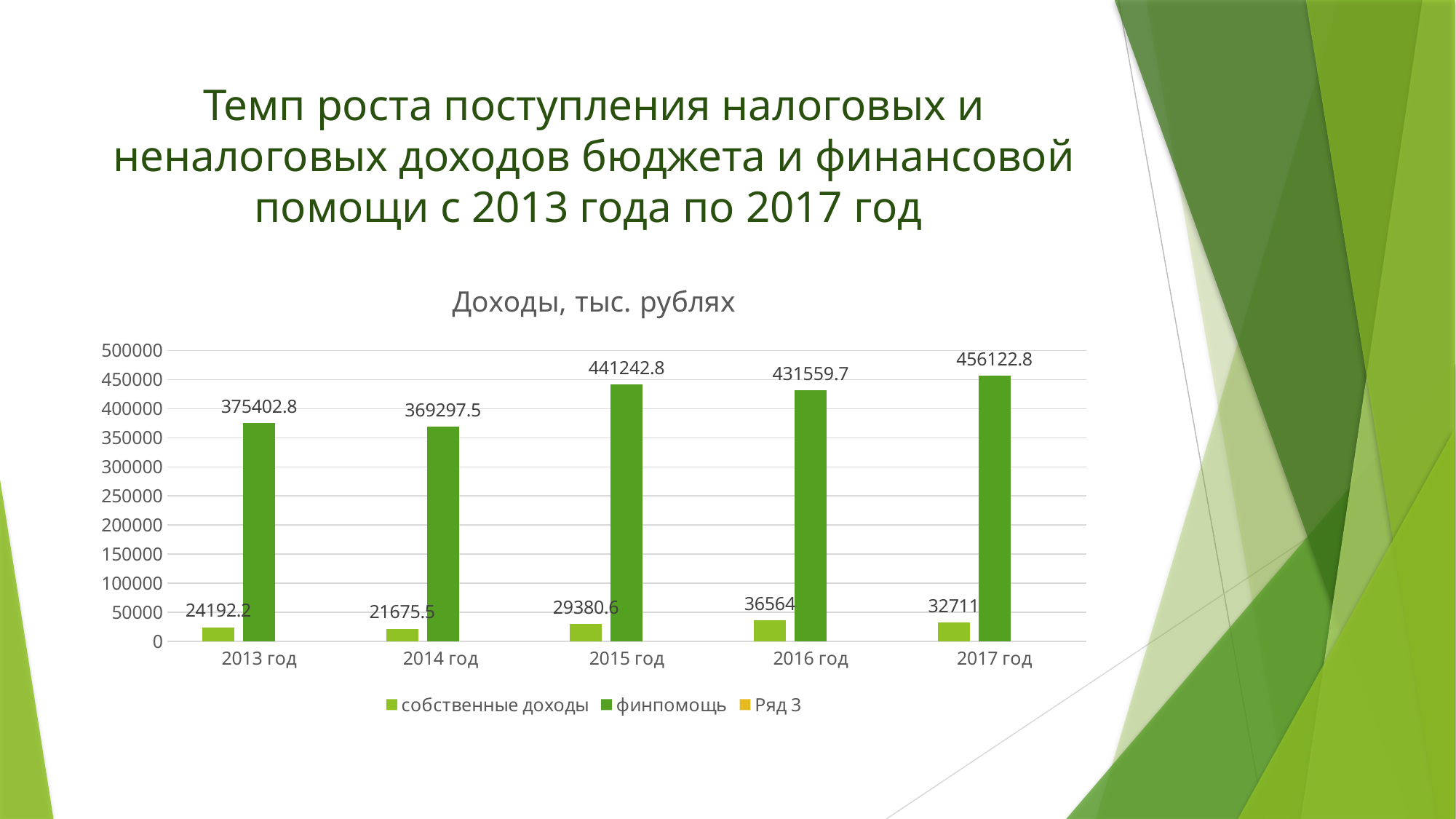
How many series does the chart legend list? 3 What is the difference between финпомощь in 2017 год and in 2013 год? 80720 What is the value of собственные доходы for 2016 год? 36564 What is the value of собственные доходы for 2014 год? 21675.5 In which year is финпомощь the highest? 2017 год How many years are shown on the x axis of the chart? 5 In which year is собственные доходы the lowest? 2014 год Which is larger: финпомощь in 2015 год or финпомощь in 2016 год? 2015 год What is the difference between собственные доходы in 2016 год and in 2014 год? 14888.5 Is the value of финпомощь for 2013 год greater or less than 350000? greater What type of chart is shown on the slide? bar chart What is the value of финпомощь for 2015 год? 441242.8